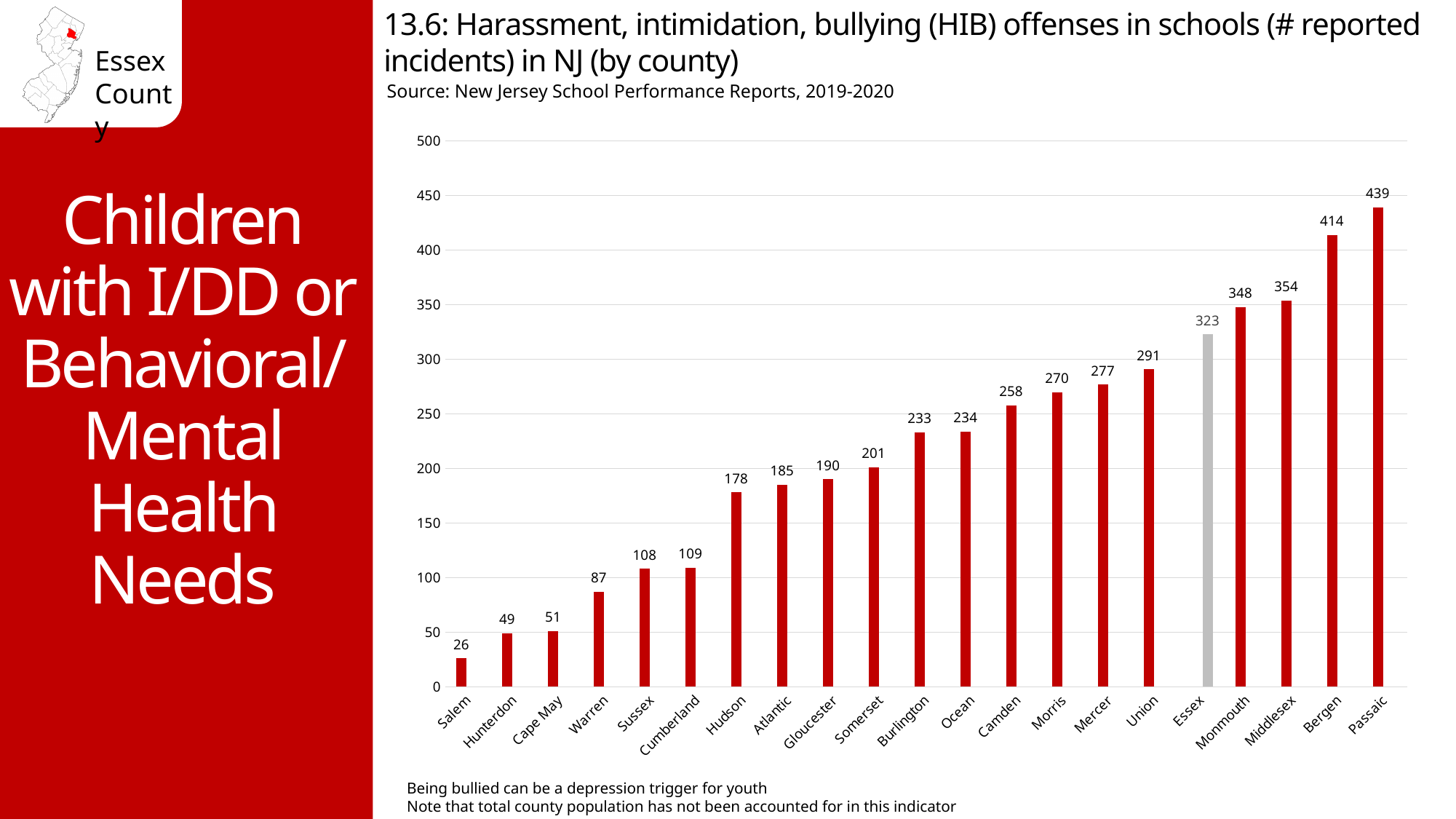
Which county has the highest number of reported HIB incidents? Passaic Is the value for Camden greater or less than 250? greater Do the values rise or fall moving from left to right along the x axis? Rise What is the number of reported HIB incidents for Essex County? 323 Which county has the lowest number of reported HIB incidents? Salem How many counties are shown on the chart? 21 What is the number of reported HIB incidents for Hudson County? 178 Which county's bar is shown in grey rather than red? Essex What is the difference in reported HIB incidents between Passaic and Bergen? 25 What kind of chart is shown on the slide? Bar chart What is the difference in reported HIB incidents between Essex and Union? 32 Which county has more reported HIB incidents, Monmouth or Middlesex? Middlesex